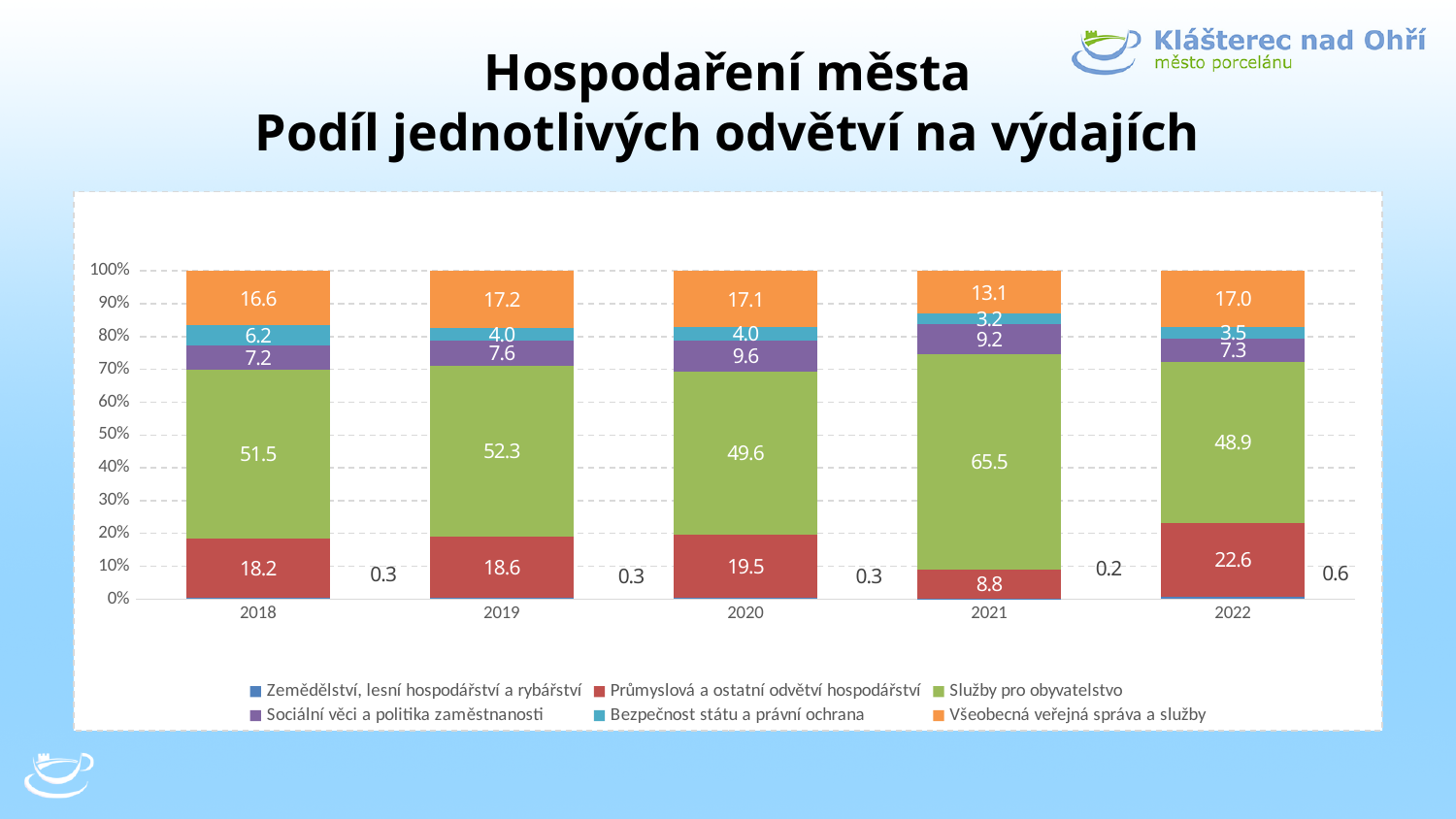
What is the value for Všeobecná veřejná správa a služby in 2018? 16.6 How many series does the legend list? 6 In which year is the share of Služby pro obyvatelstvo the highest? 2021 What is the value for Průmyslová a ostatní odvětví hospodářství in 2022? 22.6 What is the difference between the Sociální věci a politika zaměstnanosti values for 2020 and 2018? 2.4 What kind of chart is shown on the slide? Stacked bar chart How many years are shown on the x axis? 5 In which year is the share of Průmyslová a ostatní odvětví hospodářství the lowest? 2021 What is the value for Zemědělství, lesní hospodářství a rybářství in 2022? 0.6 What is the value for Služby pro obyvatelstvo in 2021? 65.5 Does the share of Průmyslová a ostatní odvětví hospodářství rise or fall from 2018 to 2020? Rise Which is larger, the Bezpečnost státu a právní ochrana value in 2018 or in 2022? 2018